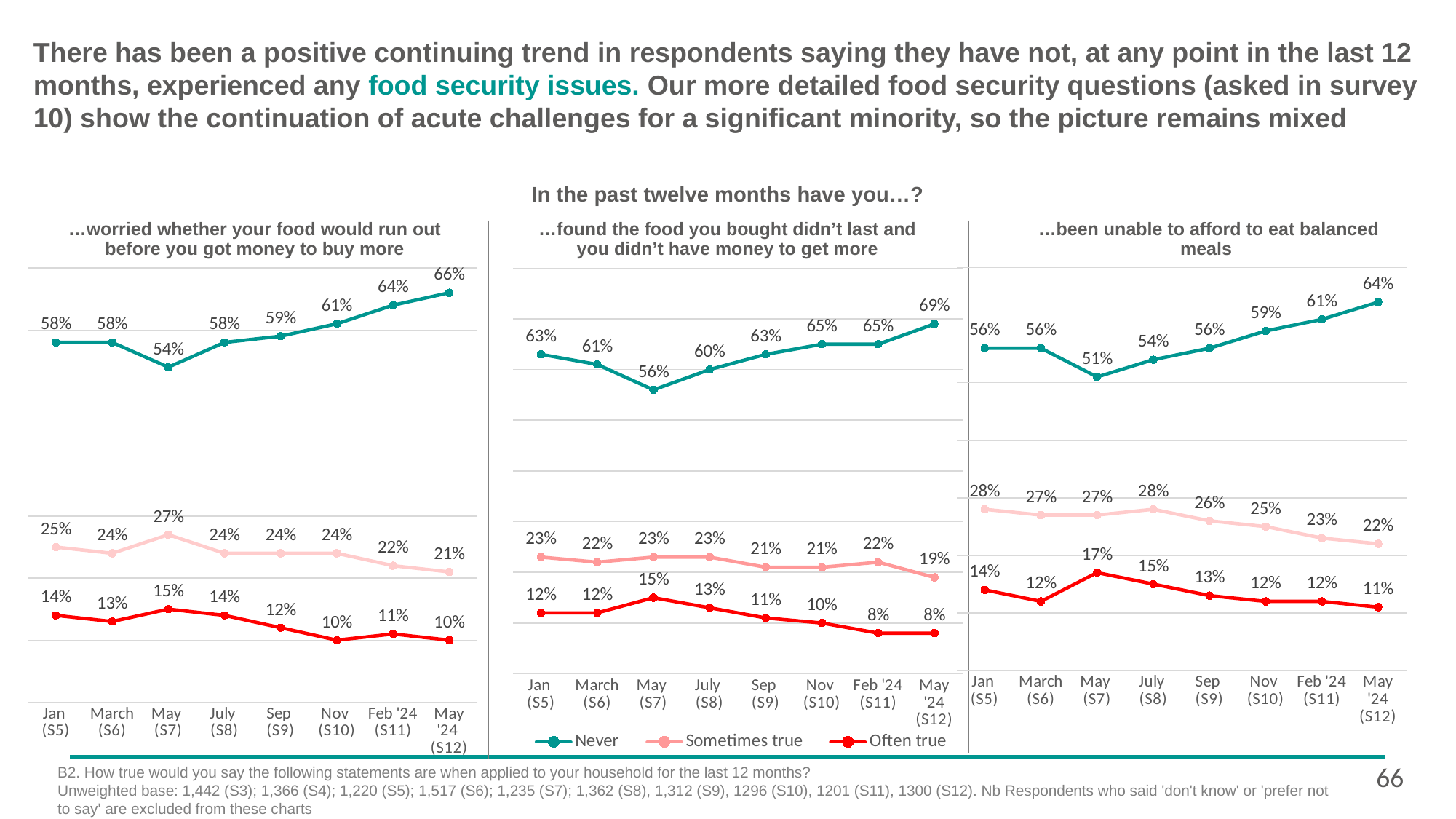
In the chart '…been unable to afford to eat balanced meals', at which survey point is the Never series lowest? May (S7) In the chart '…worried whether your food would run out before you got money to buy more', what is the difference between the Never values in Jan (S5) and May '24 (S12)? 8 percentage points In the chart '…been unable to afford to eat balanced meals', which is larger: Often true in May (S7) or Often true in May '24 (S12)? May (S7) In the chart '…worried whether your food would run out before you got money to buy more', what is the value for Never in May '24 (S12)? 66% In the chart '…found the food you bought didn't last and you didn't have money to get more', at which survey point is the Never series highest? May '24 (S12) In the chart '…found the food you bought didn't last and you didn't have money to get more', what is the value for Often true in May (S7)? 15% In the chart '…found the food you bought didn't last and you didn't have money to get more', does the Often true series generally rise or fall from May (S7) to May '24 (S12)? Fall How many series does the legend list? 3 How many survey points are plotted along the x axis of each chart? 8 What kind of chart is used for '…found the food you bought didn't last and you didn't have money to get more'? Line chart Which series is drawn in red in the charts? Often true In the chart '…been unable to afford to eat balanced meals', what is the value for Sometimes true in Jan (S5)? 28%